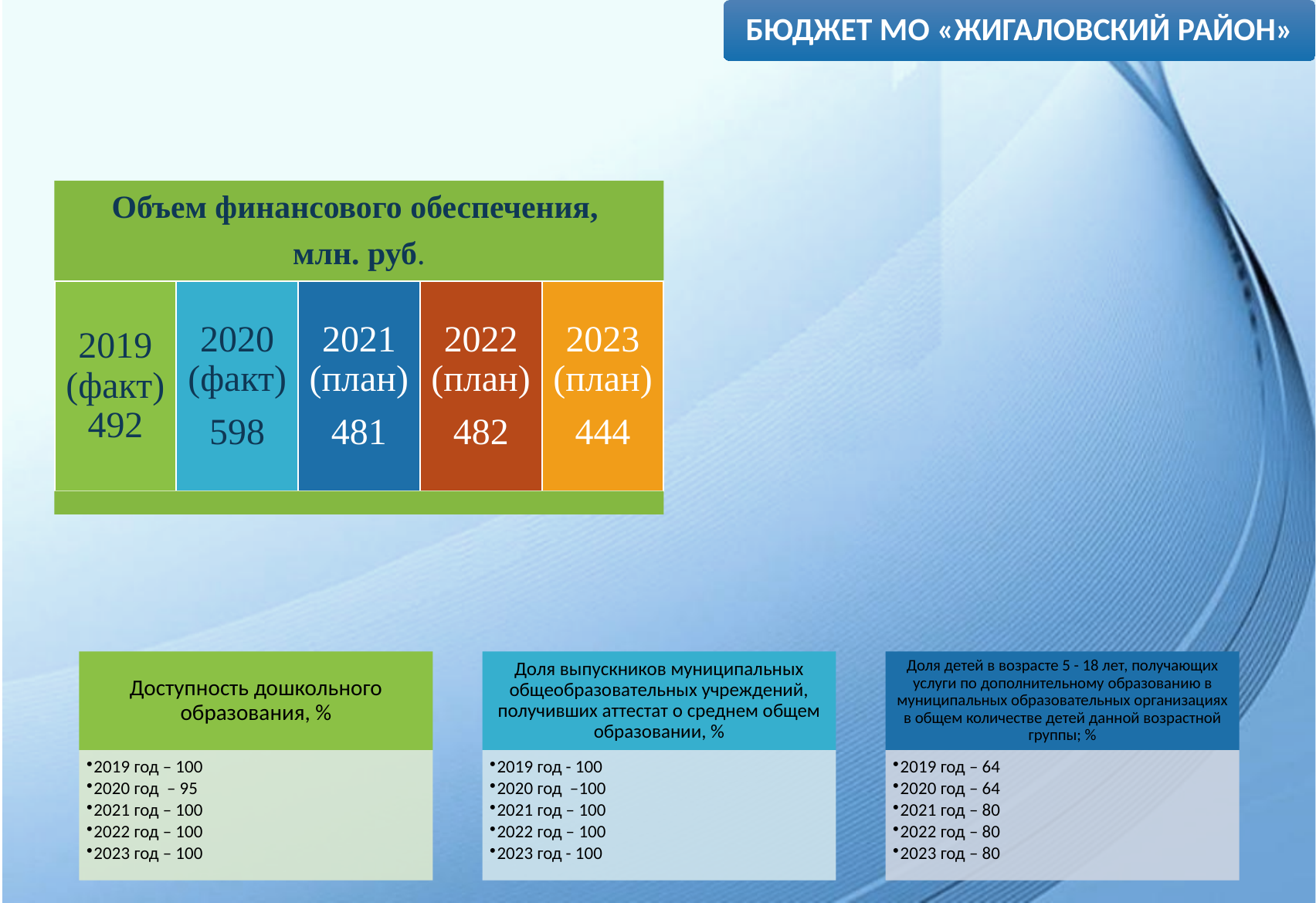
How many years are shown in the 'Объем финансового обеспечения, млн. руб.' chart? 5 In the 'Объем финансового обеспечения, млн. руб.' chart, what is the difference between the 2020 (факт) and 2019 (факт) values? 106 In the 'Объем финансового обеспечения, млн. руб.' chart, what colour is the block for 2023 (план)? orange In the 'Объем финансового обеспечения, млн. руб.' chart, do the values rise or fall from 2020 to 2023? fall In the 'Объем финансового обеспечения, млн. руб.' chart, what is the value for 2023 (план)? 444 In the 'Объем финансового обеспечения, млн. руб.' chart, which is larger: the value for 2021 (план) or 2022 (план)? 2022 (план) In the 'Объем финансового обеспечения, млн. руб.' chart, which is larger: the value for 2019 (факт) or 2020 (факт)? 2020 (факт) In the 'Объем финансового обеспечения, млн. руб.' chart, what is the value for 2021 (план)? 481 In the 'Объем финансового обеспечения, млн. руб.' chart, what is the value for 2020 (факт)? 598 In the 'Объем финансового обеспечения, млн. руб.' chart, what is the difference between the 2019 (факт) and 2023 (план) values? 48 In the 'Объем финансового обеспечения, млн. руб.' chart, which year has the highest value? 2020 (факт) In the 'Объем финансового обеспечения, млн. руб.' chart, which year has the lowest value? 2023 (план)